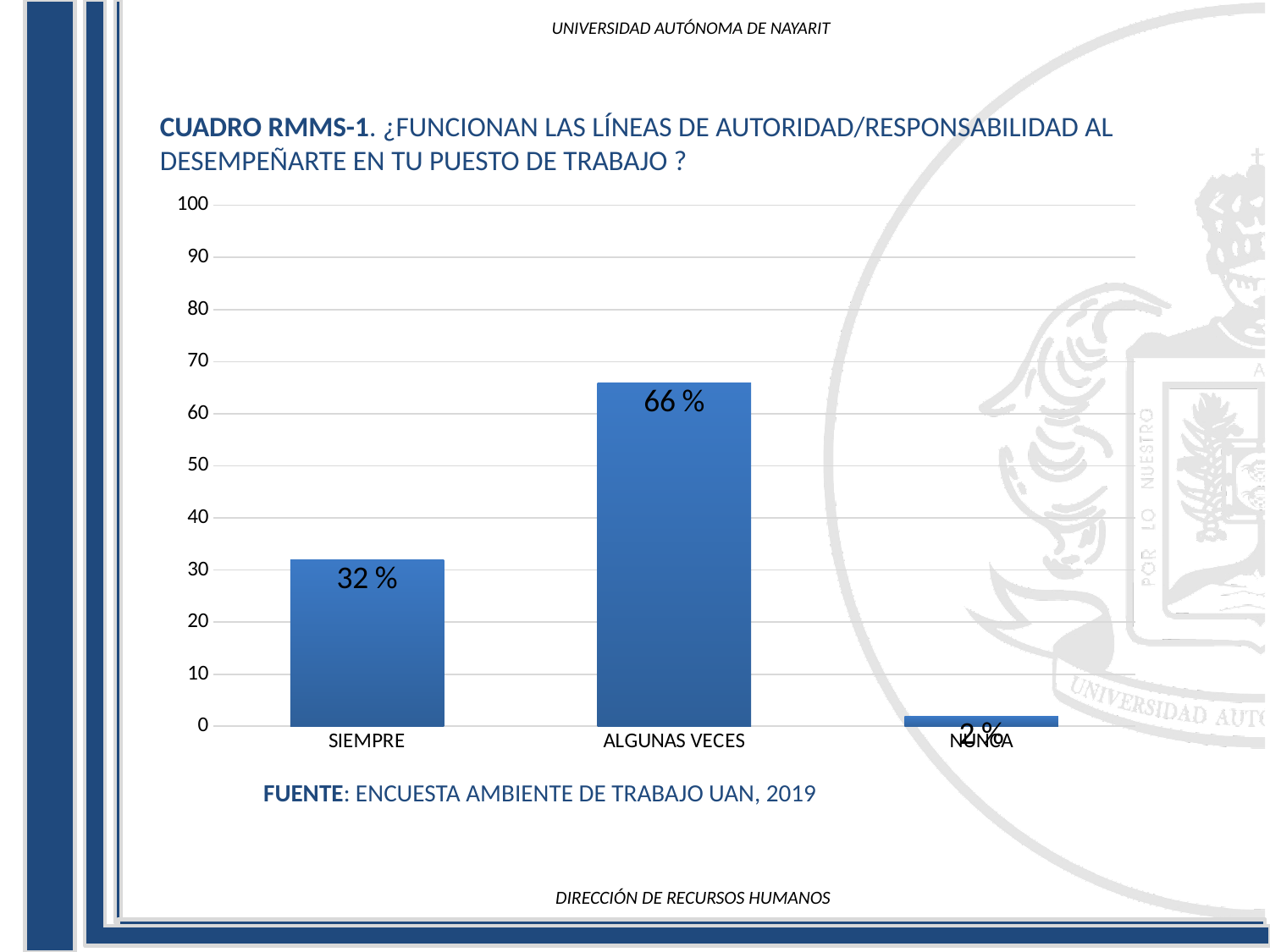
What is the difference between the values for ALGUNAS VECES and SIEMPRE? 34 % Is the value for ALGUNAS VECES greater or less than 60? greater Is the value for SIEMPRE greater or less than 40? less What is the value for NUNCA? 2 % What is the value for ALGUNAS VECES? 66 % What kind of chart is shown on the slide? bar chart How many categories are shown on the x axis? 3 Which category has the highest value? ALGUNAS VECES Which is larger, the value for SIEMPRE or the value for NUNCA? SIEMPRE What source is cited below the chart? ENCUESTA AMBIENTE DE TRABAJO UAN, 2019 Which category has the lowest value? NUNCA What is the value for SIEMPRE? 32 %